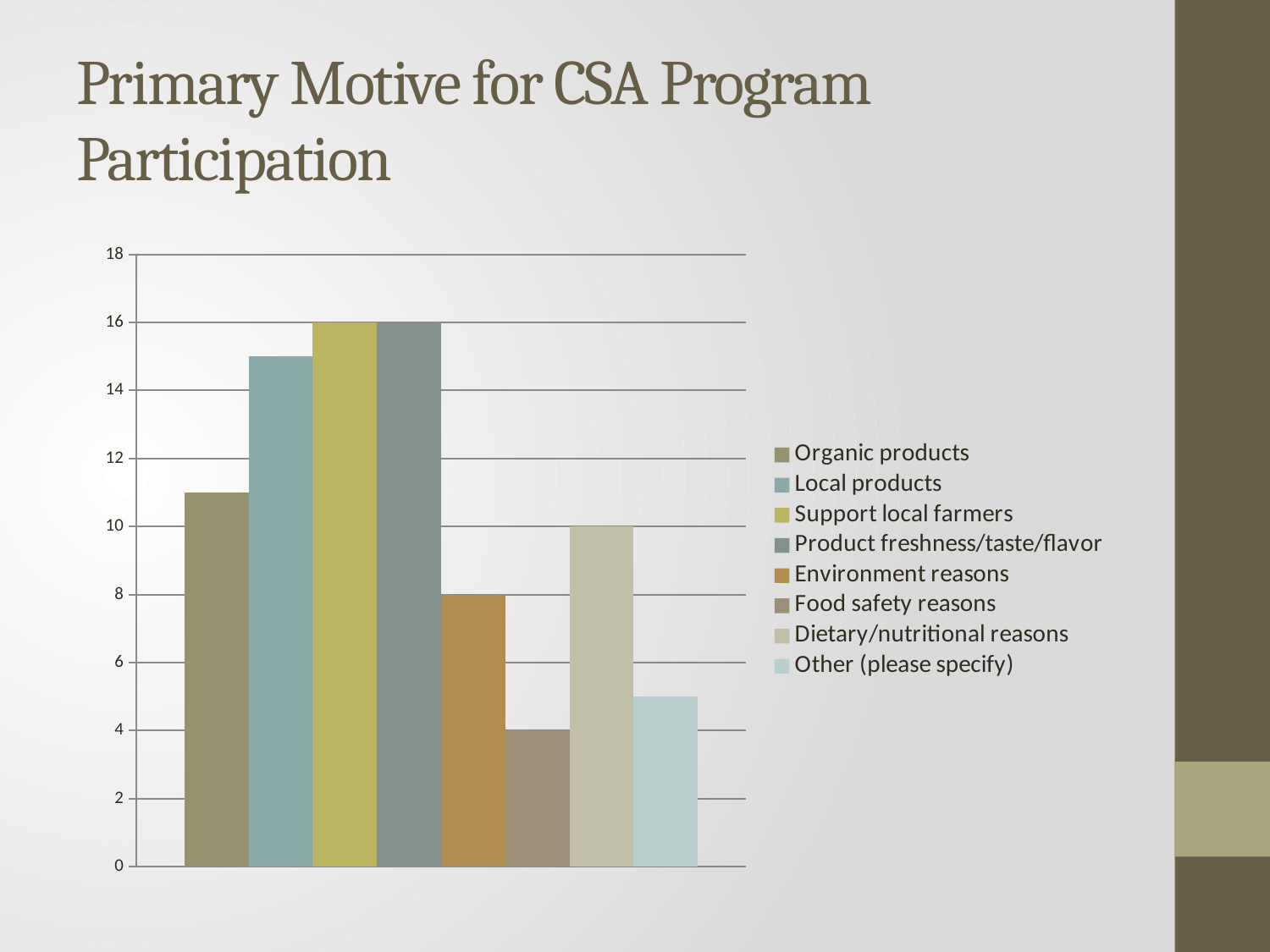
How many entries does the legend list? 8 Is the value for Organic products greater or less than 10? greater How many bars are plotted in the chart? 8 Is the value for Other (please specify) greater or less than 6? less Which is larger, the value for Local products or the value for Environment reasons? Local products What is the value for Product freshness/taste/flavor? 16 What is the value for Support local farmers? 16 What is the value for Food safety reasons? 4 What type of chart is shown on the slide? bar chart Which motive has the lowest value? Food safety reasons What is the value for Environment reasons? 8 What is the value for Dietary/nutritional reasons? 10